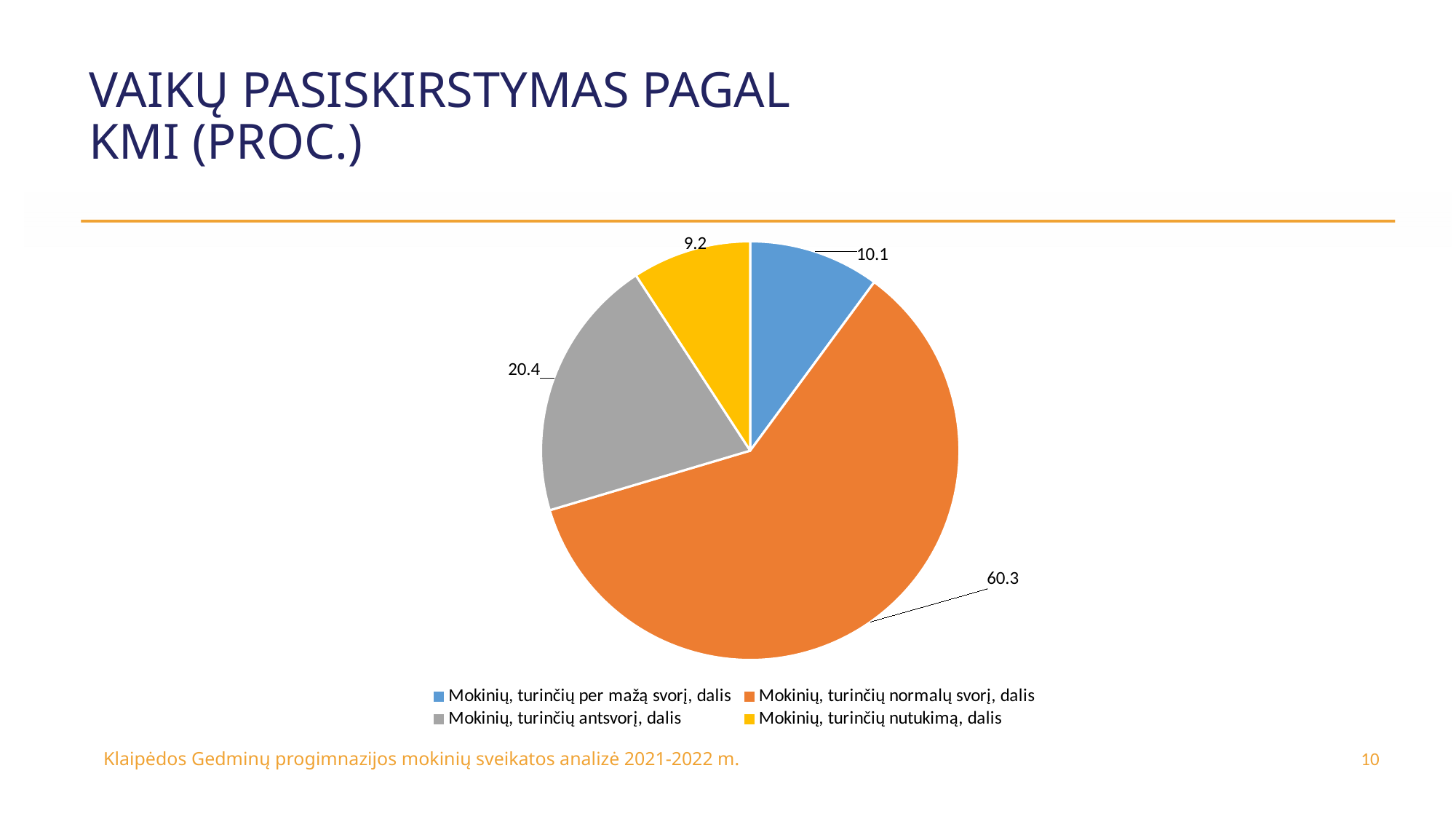
Which category has the smallest slice? Mokinių, turinčių nutukimą, dalis What is the value for "Mokinių, turinčių per mažą svorį, dalis"? 10.1 Which is larger: the value for "Mokinių, turinčių antsvorį, dalis" or "Mokinių, turinčių nutukimą, dalis"? Mokinių, turinčių antsvorį, dalis What is the title of the slide containing the chart? VAIKŲ PASISKIRSTYMAS PAGAL KMI (PROC.) What is the value for "Mokinių, turinčių antsvorį, dalis"? 20.4 How many slices does the pie chart have? 4 What is the difference between the values for "Mokinių, turinčių antsvorį, dalis" and "Mokinių, turinčių per mažą svorį, dalis"? 10.3 What is the value for "Mokinių, turinčių normalų svorį, dalis"? 60.3 What is the value for "Mokinių, turinčių nutukimą, dalis"? 9.2 What colour is the slice for "Mokinių, turinčių nutukimą, dalis"? yellow Which category has the largest slice? Mokinių, turinčių normalų svorį, dalis What kind of chart is shown on the slide? pie chart